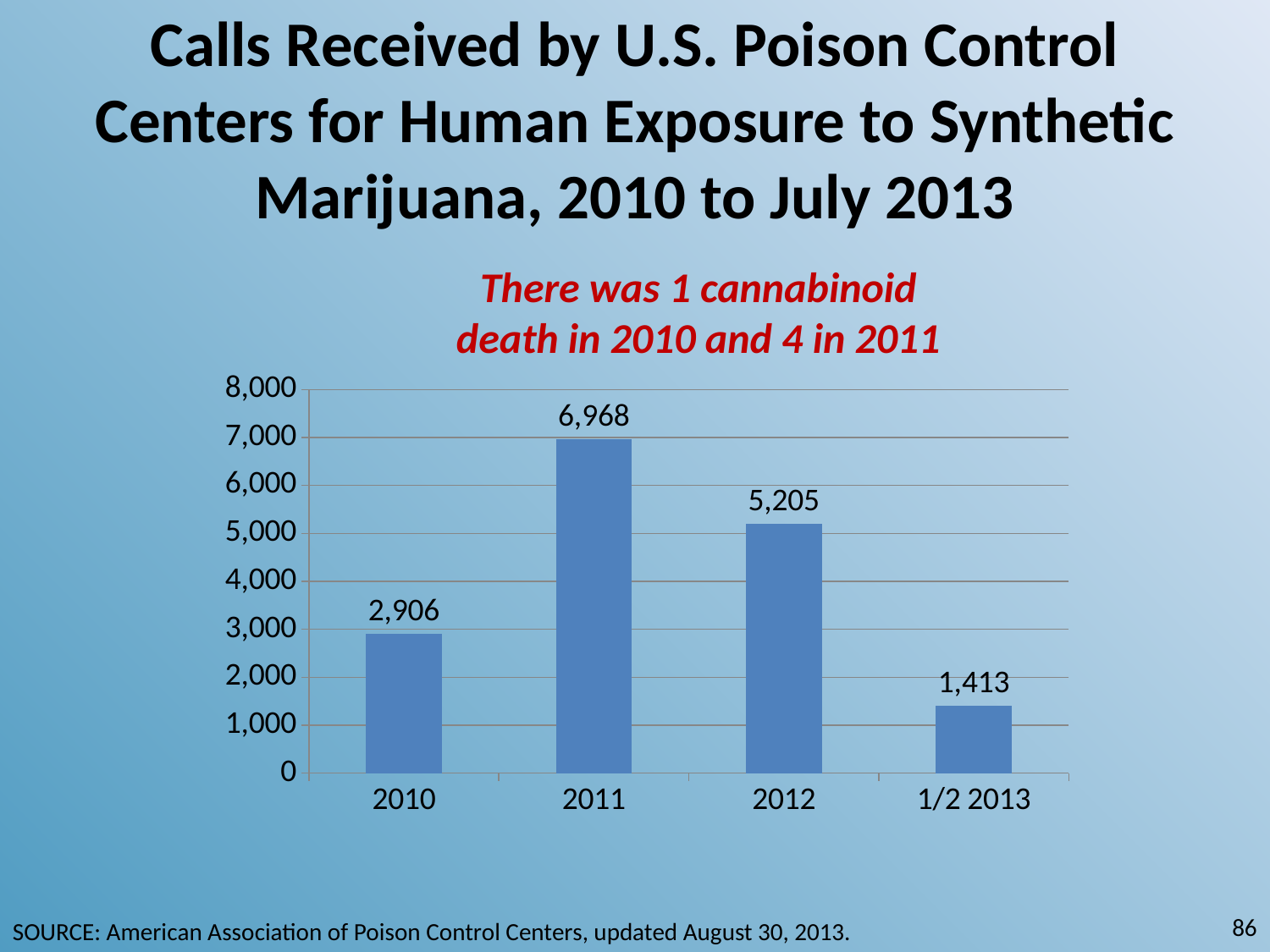
Is the value for 2012 greater or less than 5,000? greater What kind of chart is shown on the slide? bar chart What is the value shown for 2010? 2,906 What is the difference between the 2011 and 2012 values? 1,763 How many categories are shown on the x axis? 4 Which category has the lowest value? 1/2 2013 How many calls were received in 2011? 6,968 Which is larger, the value for 2010 or the value for 2012? 2012 According to the red text on the slide, how many cannabinoid deaths were there in 2011? 4 How many calls are shown for 1/2 2013? 1,413 Which year has the highest number of calls? 2011 How much higher is the 2012 value than the 2010 value? 2,299